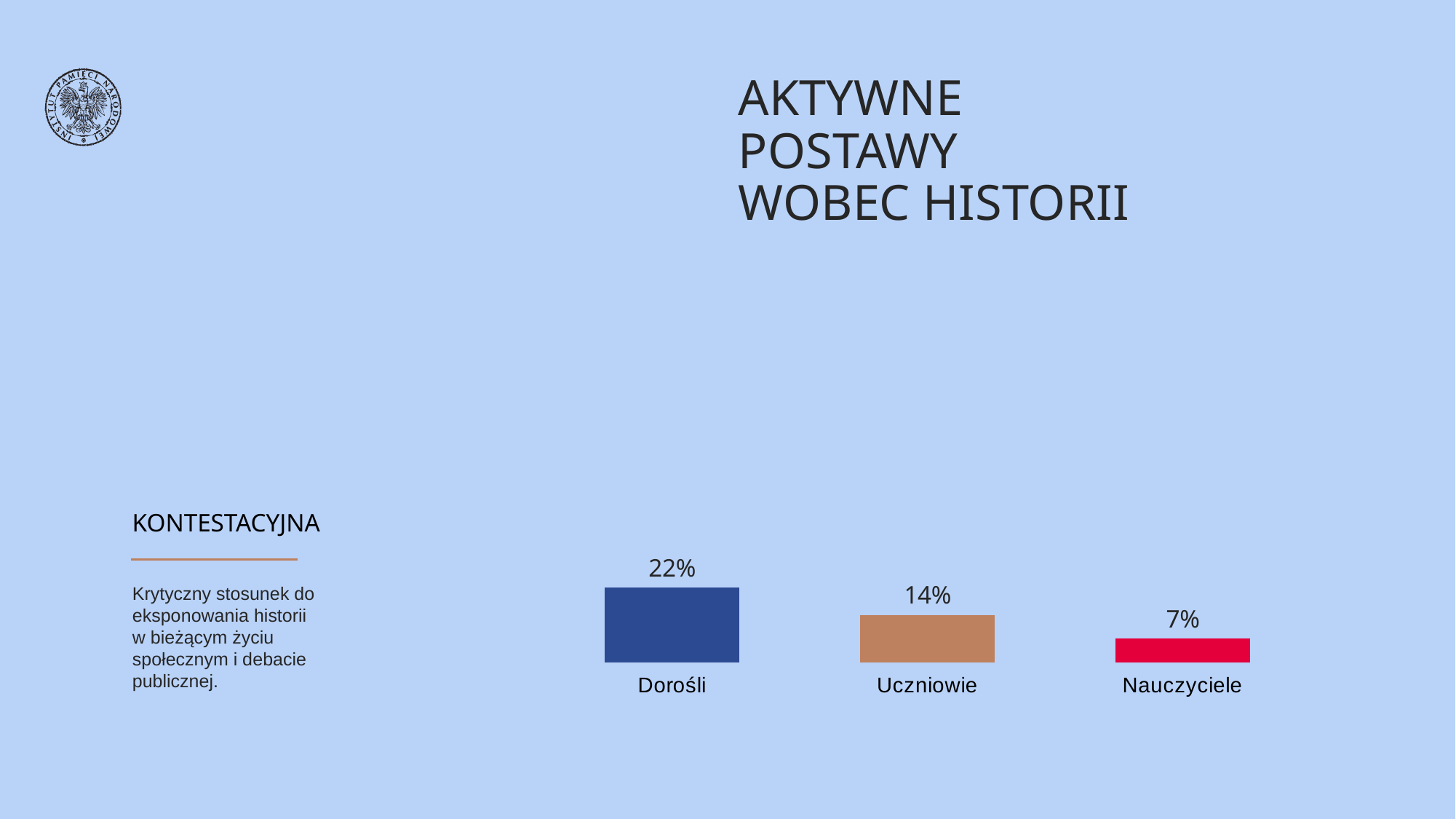
Which category has the highest value? Dorośli What is the value for Dorośli? 22% What is the value for Uczniowie? 14% Which category has the lowest value? Nauczyciele How many categories are shown in the chart? 3 What is the value for Nauczyciele? 7% What kind of chart is shown on the slide? Bar chart Do the values rise or fall from left to right across the categories? Fall What is the difference between the values for Uczniowie and Nauczyciele? 7% Which is larger, the value for Uczniowie or the value for Nauczyciele? Uczniowie What colour is the bar for Nauczyciele? Red What is the difference between the values for Dorośli and Uczniowie? 8%